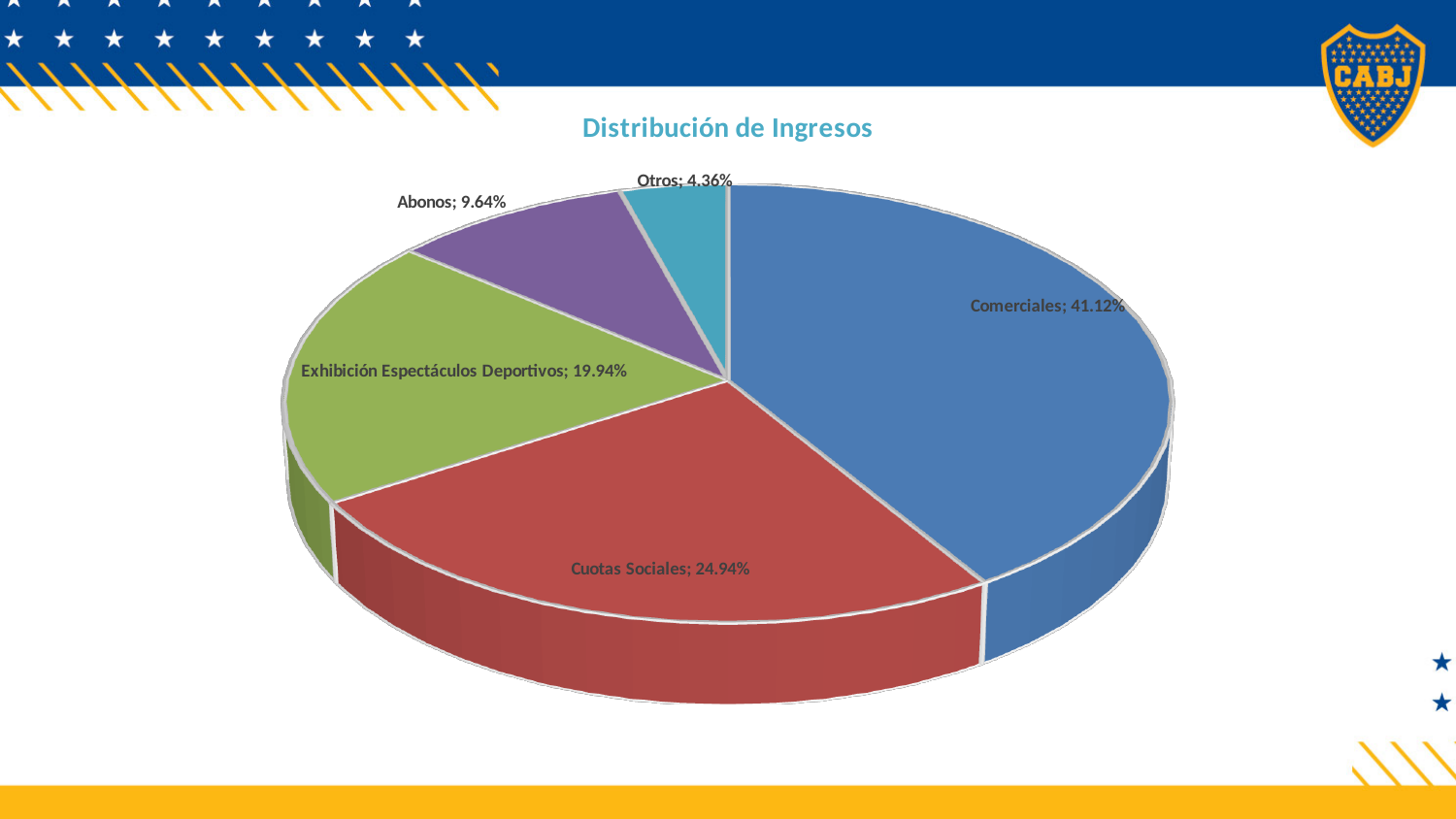
Which category has the smallest share of the pie? Otros What share of the pie does Comerciales represent? 41.12% What is the value shown for Cuotas Sociales? 24.94% What is the difference in percentage points between Comerciales and Cuotas Sociales? 16.18 What is the value shown for Abonos? 9.64% What is the value shown for Otros? 4.36% Which category has the largest share of the pie? Comerciales How many slices does the pie chart have? 5 What kind of chart is shown on the slide? pie chart What is the value shown for Exhibición Espectáculos Deportivos? 19.94% Which is larger, Abonos or Exhibición Espectáculos Deportivos? Exhibición Espectáculos Deportivos What is the title of the chart? Distribución de Ingresos